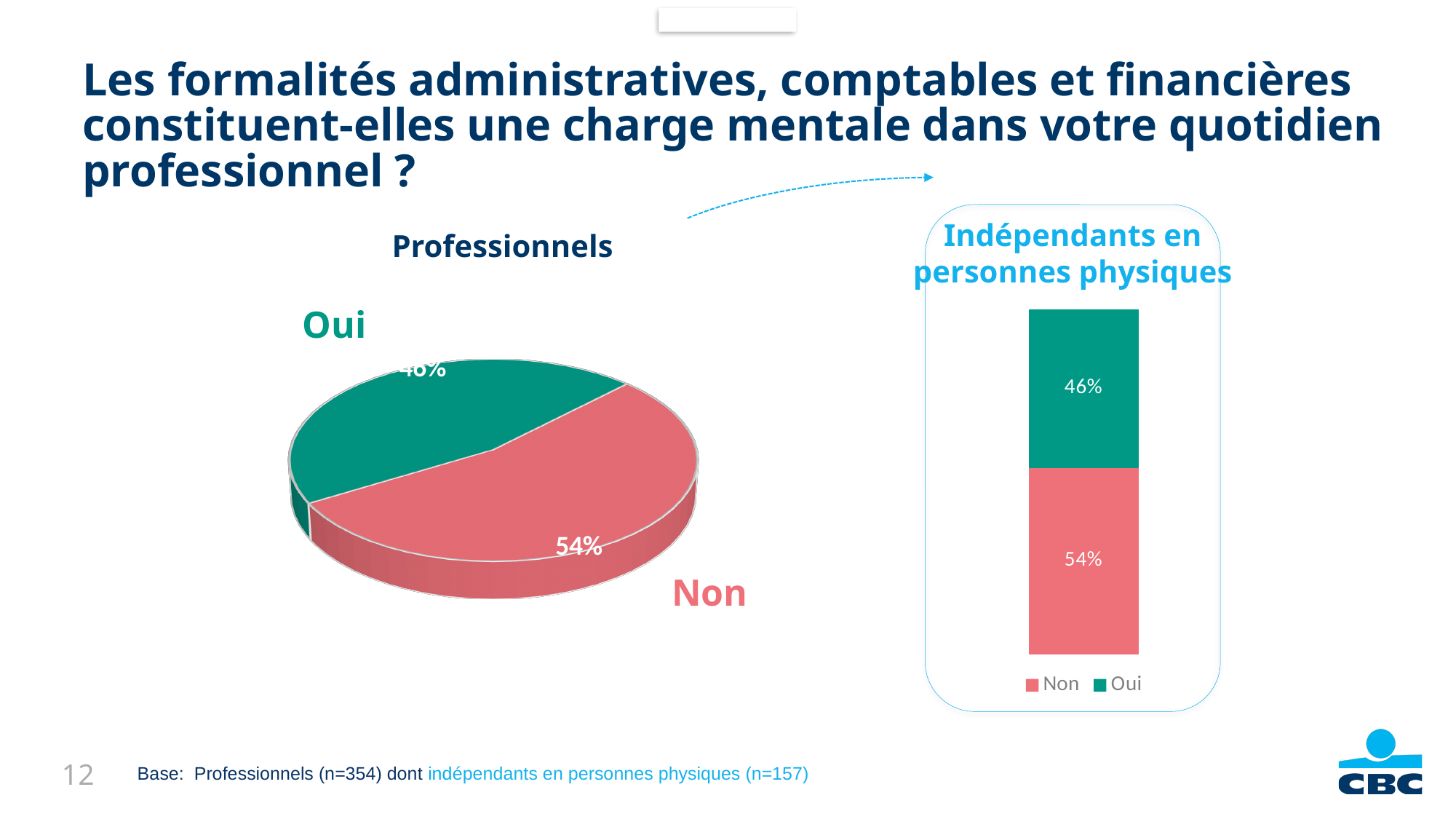
In the 'Indépendants en personnes physiques' chart, what is the value for Non? 54% How many series does the legend of the 'Indépendants en personnes physiques' chart list? 2 In the 'Professionnels' pie chart, what is the difference between the Non and Oui shares? 8% In the 'Indépendants en personnes physiques' chart, what is the value for Oui? 46% What type of chart is the 'Indépendants en personnes physiques' chart? stacked bar chart In the 'Indépendants en personnes physiques' chart, is the value for Non larger or smaller than the value for Oui? larger In the 'Professionnels' pie chart, what percentage answered Non? 54% In the 'Indépendants en personnes physiques' chart, what is the total of the stacked bar? 100% In the 'Professionnels' pie chart, which answer has the larger share? Non In the 'Indépendants en personnes physiques' chart, which answer has the smaller value? Oui In the 'Professionnels' pie chart, what percentage answered Oui? 46% What type of chart is the 'Professionnels' chart? pie chart